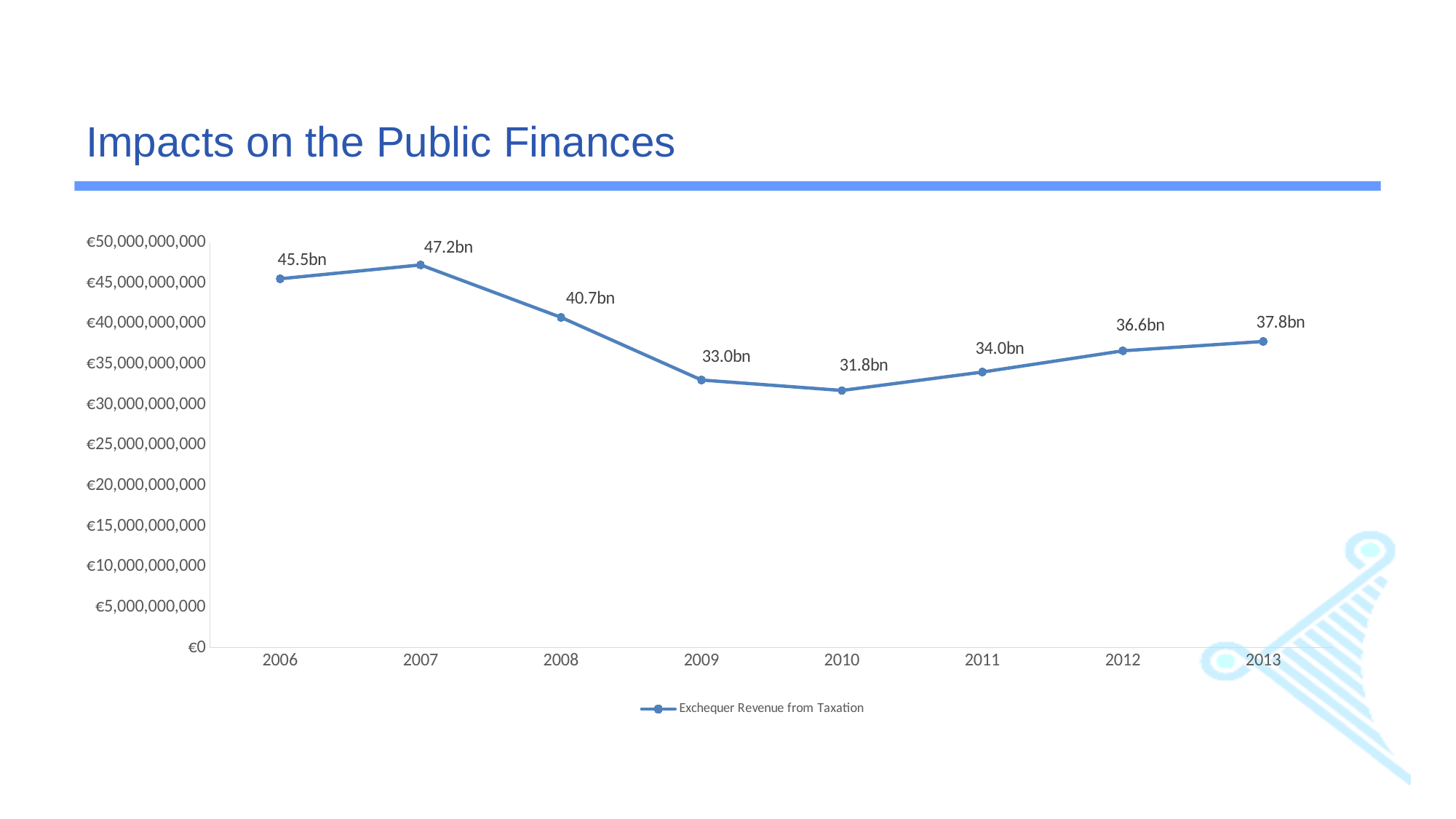
Does the Exchequer Revenue from Taxation rise or fall from 2007 to 2010? fall Is the value for 2009 greater or less than €35,000,000,000? less Which year has the larger Exchequer Revenue from Taxation, 2008 or 2012? 2008 What is the difference between the Exchequer Revenue from Taxation in 2007 and in 2010? 15.4bn What is the Exchequer Revenue from Taxation for 2007? 47.2bn Which year has the lowest Exchequer Revenue from Taxation? 2010 What is the Exchequer Revenue from Taxation for 2010? 31.8bn Which year has the highest Exchequer Revenue from Taxation? 2007 What is the Exchequer Revenue from Taxation for 2013? 37.8bn What kind of chart is shown on the slide? line chart How many series does the legend list? 1 How many years are plotted on the chart? 8